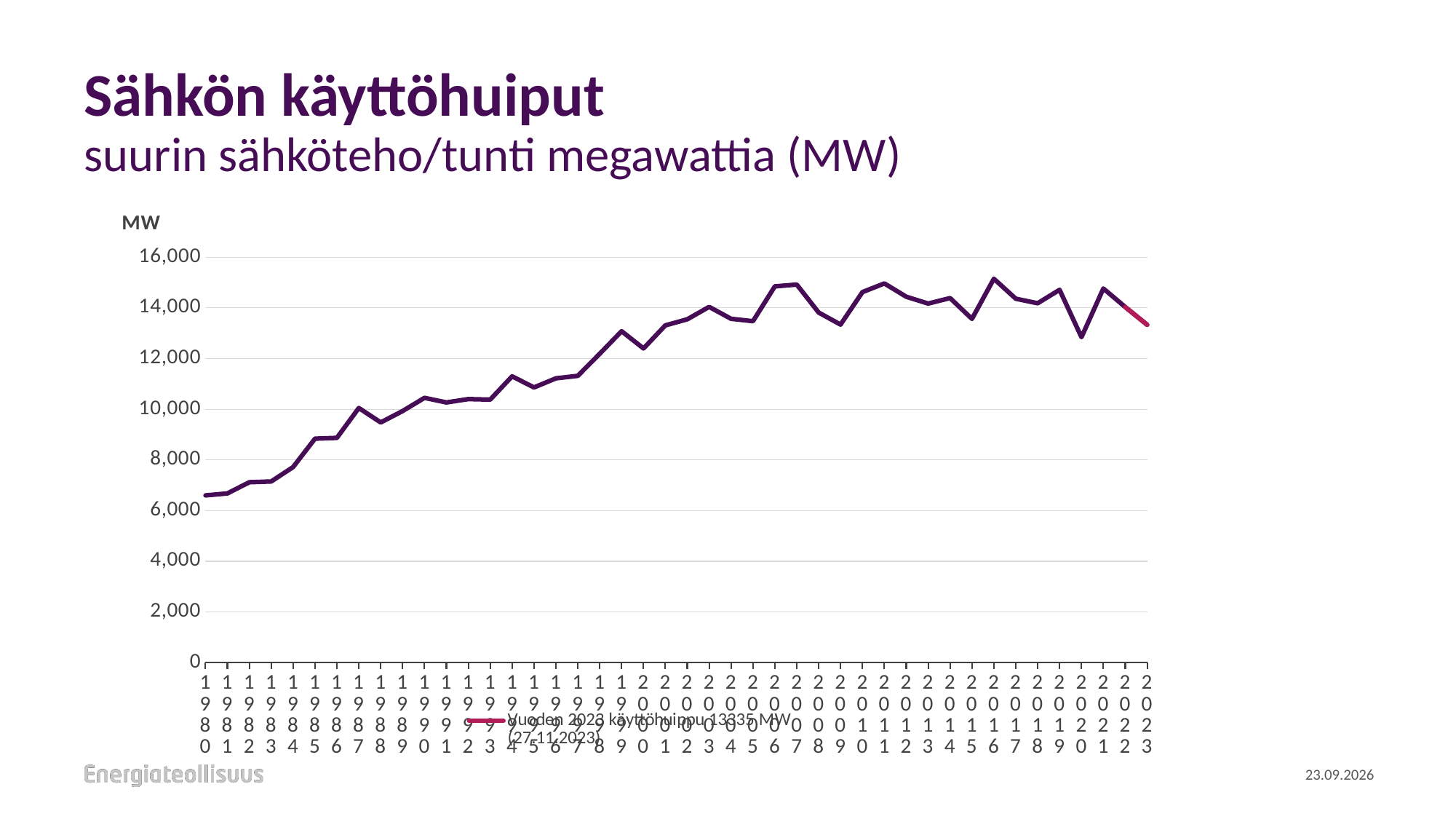
How many years are plotted on the x axis? 44 Which year has the larger peak usage, 2020 or 2021? 2021 Does the peak electricity usage generally rise or fall from 1980 to 2023? rise Is the value for 2007 greater or less than 10,000? greater Which year has the larger peak usage, 1990 or 2000? 2000 Which year has the lowest peak electricity usage on the chart? 1980 Is the value for 2016 greater or less than 14,000? greater Is the value for 1980 greater or less than 8,000? less What kind of chart is shown on the slide? line chart What is the 2023 peak electricity usage (käyttöhuippu) stated in the legend? 13335 MW On what date did the 2023 peak usage occur, according to the legend? 27.11.2023